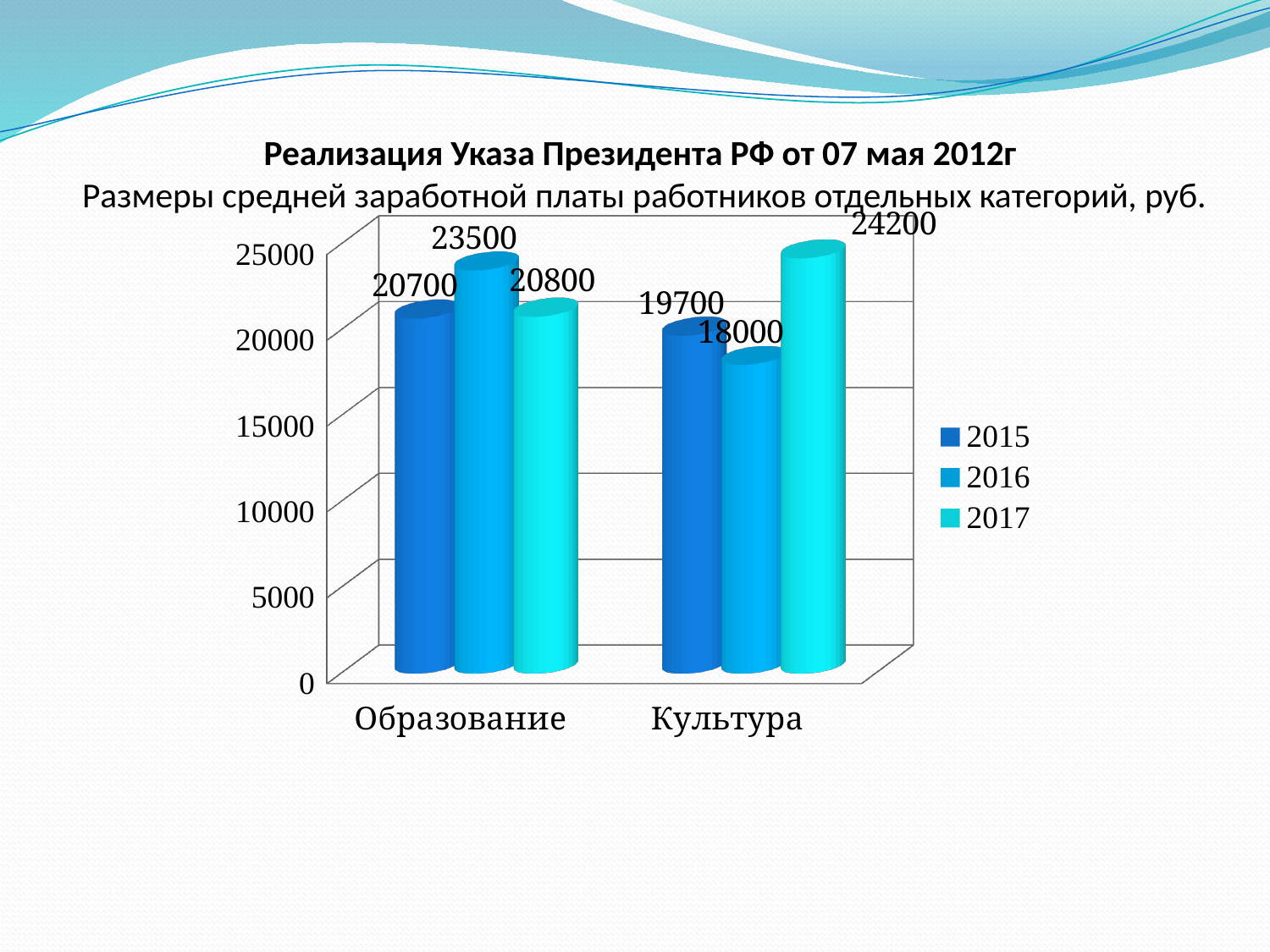
How many categories are shown on the x axis? 2 What is the value for Образование in 2015? 20700 What is the difference between the 2016 and 2015 values for Образование? 2800 Which category has the highest value in 2017? Культура Which category has the lowest value in 2016? Культура What is the difference between the 2017 and 2016 values for Культура? 6200 What is the value for Культура in 2017? 24200 What kind of chart is shown on the slide? Bar chart How many series does the legend list? 3 What is the value for Образование in 2016? 23500 Which is larger: the 2015 value for Образование or the 2015 value for Культура? Образование What is the value for Культура in 2016? 18000